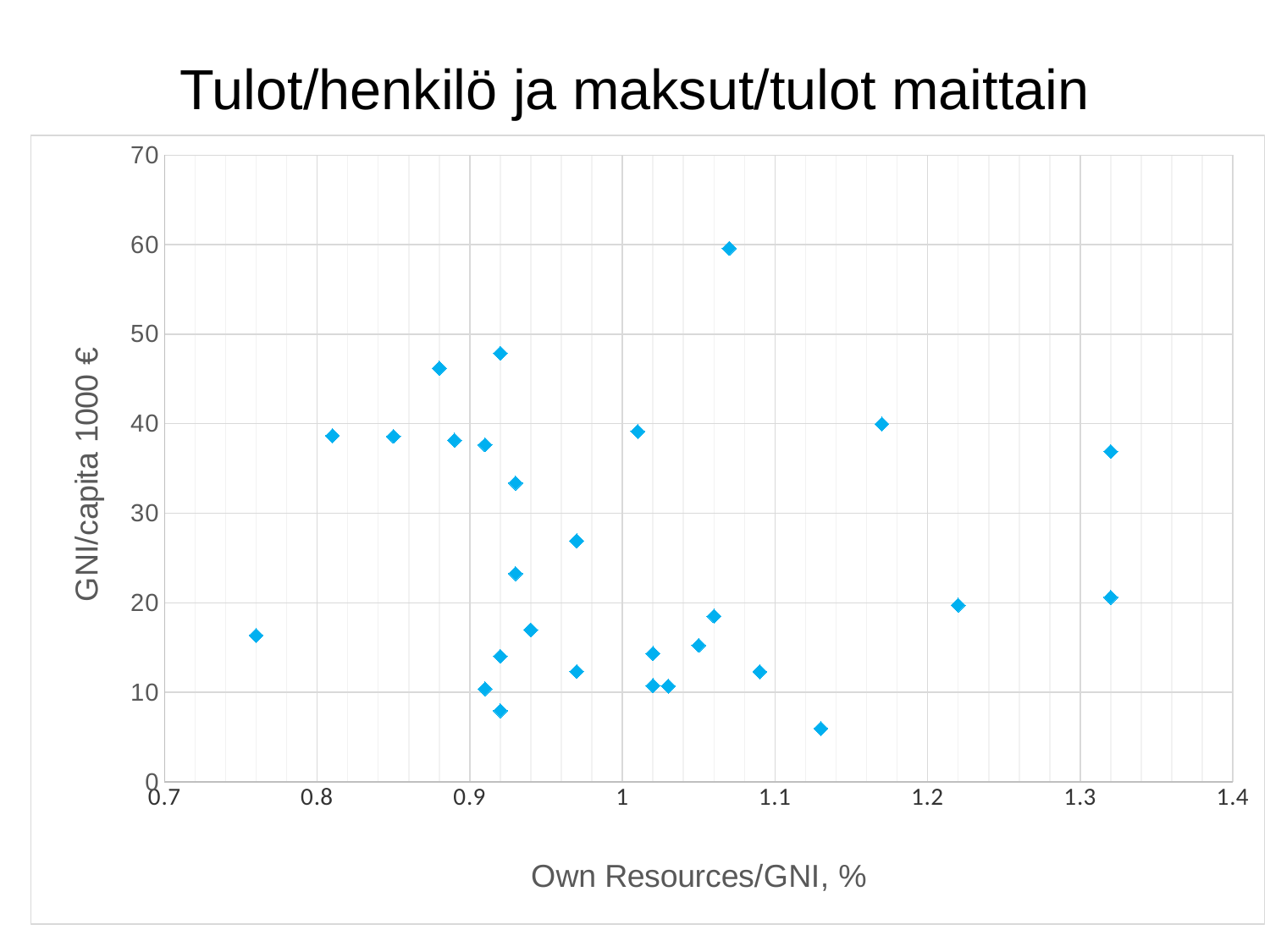
What kind of chart is shown on the slide? scatter chart Is the Own Resources/GNI value of the rightmost points greater or less than 1.3? greater How many data points are plotted on the chart? 28 Is the GNI/capita value of the lowest point on the chart greater or less than 10? less What is the label of the horizontal axis? Own Resources/GNI, % Is the Own Resources/GNI value of the leftmost point greater or less than 0.8? less What is the title of the chart? Tulot/henkilö ja maksut/tulot maittain